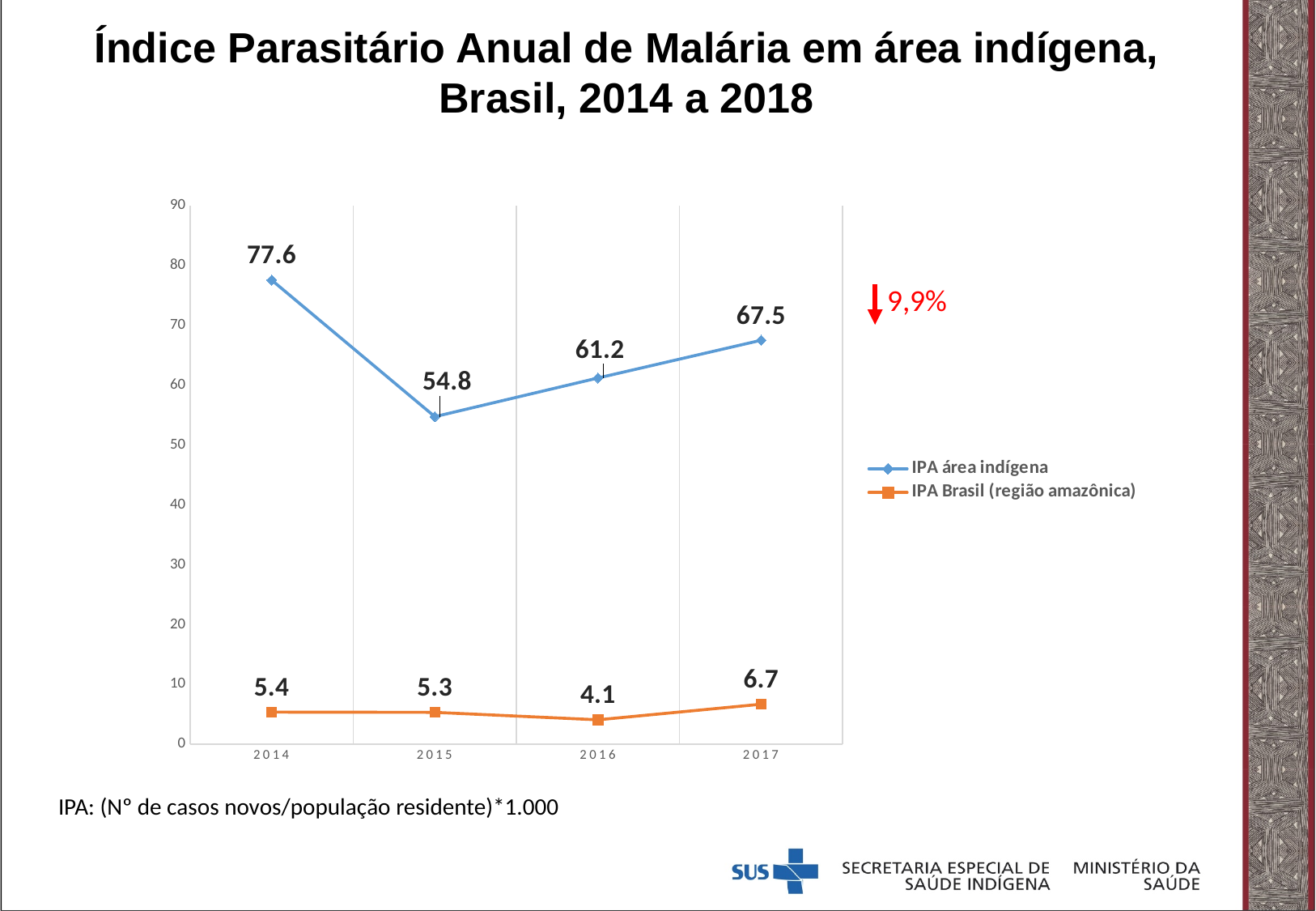
What percentage is shown next to the red arrow to the right of the chart? 9,9% How many years are shown on the x axis? 4 Which is larger: IPA área indígena in 2016 or in 2017? 2017 What is the value of IPA área indígena in 2017? 67.5 Does IPA área indígena rise or fall from 2015 to 2017? rise In which year is IPA área indígena lowest? 2015 What is the difference between IPA área indígena in 2014 and 2015? 22.8 How many series does the legend list? 2 What is the value of IPA Brasil (região amazônica) in 2016? 4.1 What kind of chart is shown? line chart What is the value of IPA área indígena in 2014? 77.6 In which year is IPA Brasil (região amazônica) highest? 2017